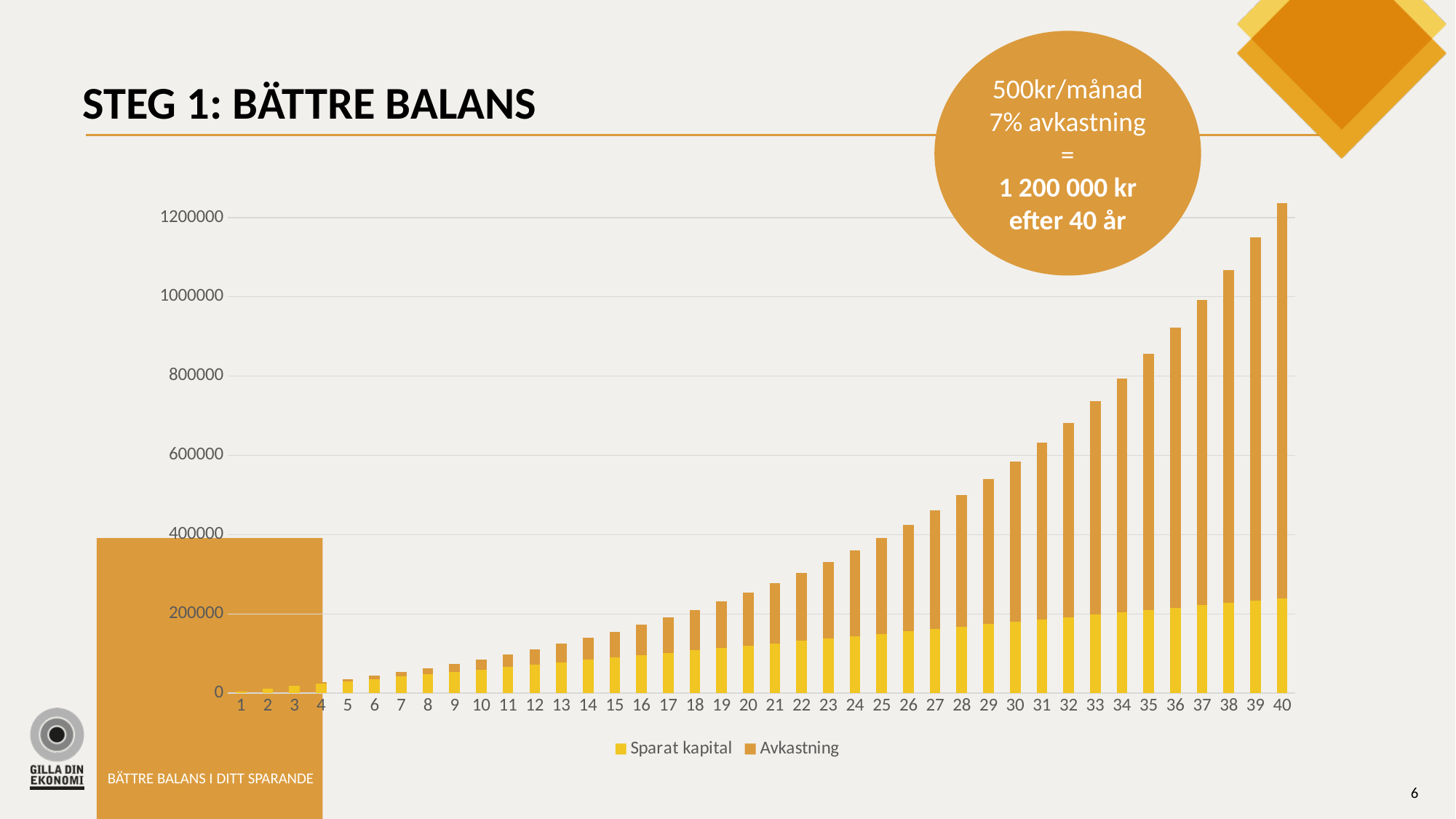
How many series does the legend list? 2 Is the total value for year 20 greater or less than 200000? greater Is the total value for year 38 greater or less than 1000000? greater Which year has the lowest total bar? 1 Is the total value for year 35 greater or less than 800000? greater What kind of chart is shown on the slide? Stacked bar chart Do the total bar values rise or fall as the years increase along the x axis? Rise Which has the larger total bar, year 20 or year 30? Year 30 Which year has the highest total bar? 40 What are the two series named in the legend? Sparat kapital and Avkastning How many categories (years) are shown on the x axis? 40